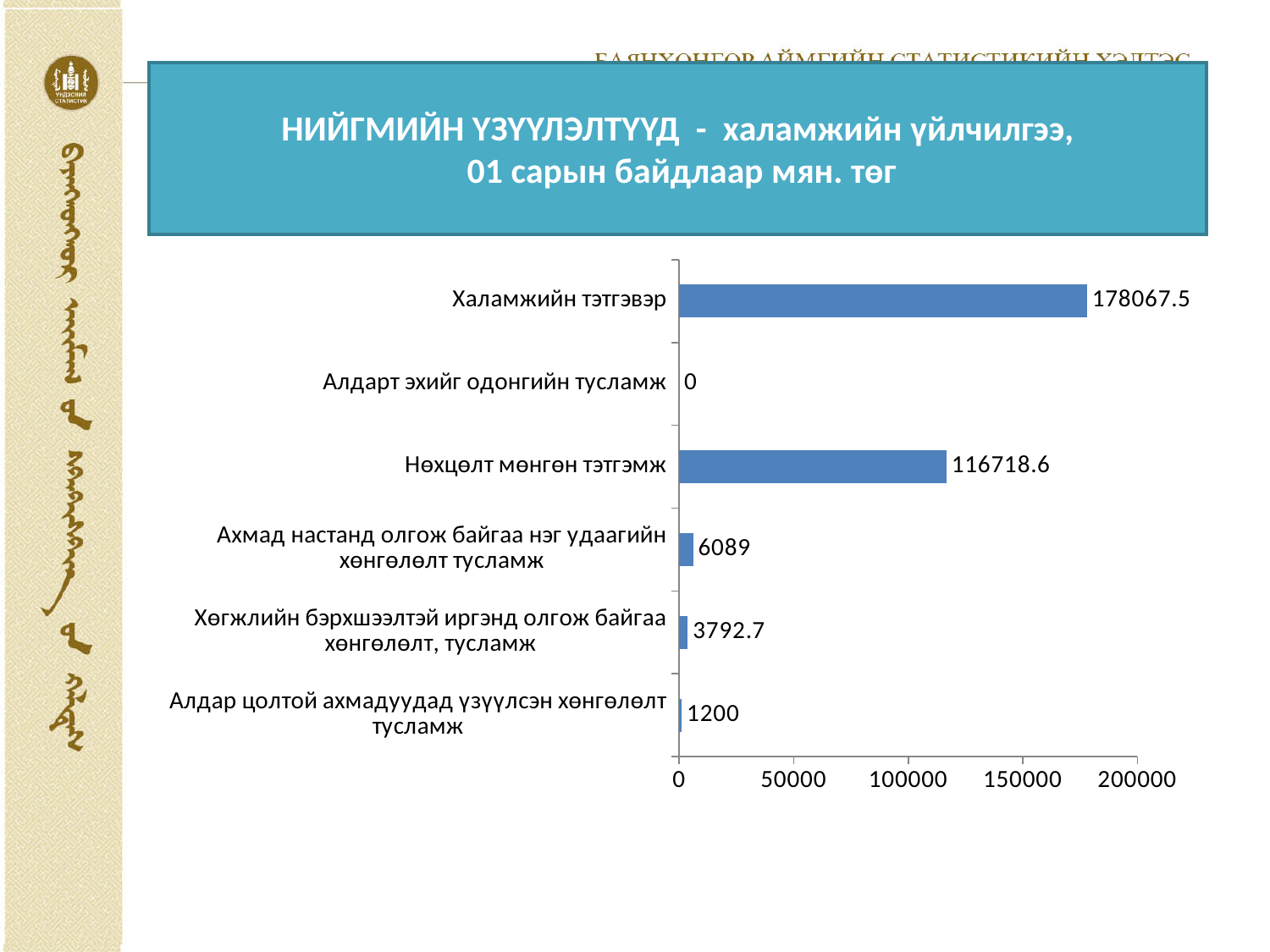
What is the value for Халамжийн тэтгэвэр? 178067.5 Which category has the lowest value? Алдарт эхийг одонгийн тусламж Which is larger: the value for Хөгжлийн бэрхшээлтэй иргэнд олгож байгаа хөнгөлөлт, тусламж or the value for Алдар цолтой ахмадуудад үзүүлсэн хөнгөлөлт тусламж? Хөгжлийн бэрхшээлтэй иргэнд олгож байгаа хөнгөлөлт, тусламж Is the value for Нөхцөлт мөнгөн тэтгэмж greater or less than 100000? greater What is the difference between the values for Ахмад настанд олгож байгаа нэг удаагийн хөнгөлөлт тусламж and Хөгжлийн бэрхшээлтэй иргэнд олгож байгаа хөнгөлөлт, тусламж? 2296.3 What is the value for Нөхцөлт мөнгөн тэтгэмж? 116718.6 What is the value for Ахмад настанд олгож байгаа нэг удаагийн хөнгөлөлт тусламж? 6089 What is the difference between the values for Халамжийн тэтгэвэр and Нөхцөлт мөнгөн тэтгэмж? 61348.9 How many categories are shown in the chart? 6 What kind of chart is shown on the slide? bar chart Which category has the highest value? Халамжийн тэтгэвэр What is the value for Алдар цолтой ахмадуудад үзүүлсэн хөнгөлөлт тусламж? 1200